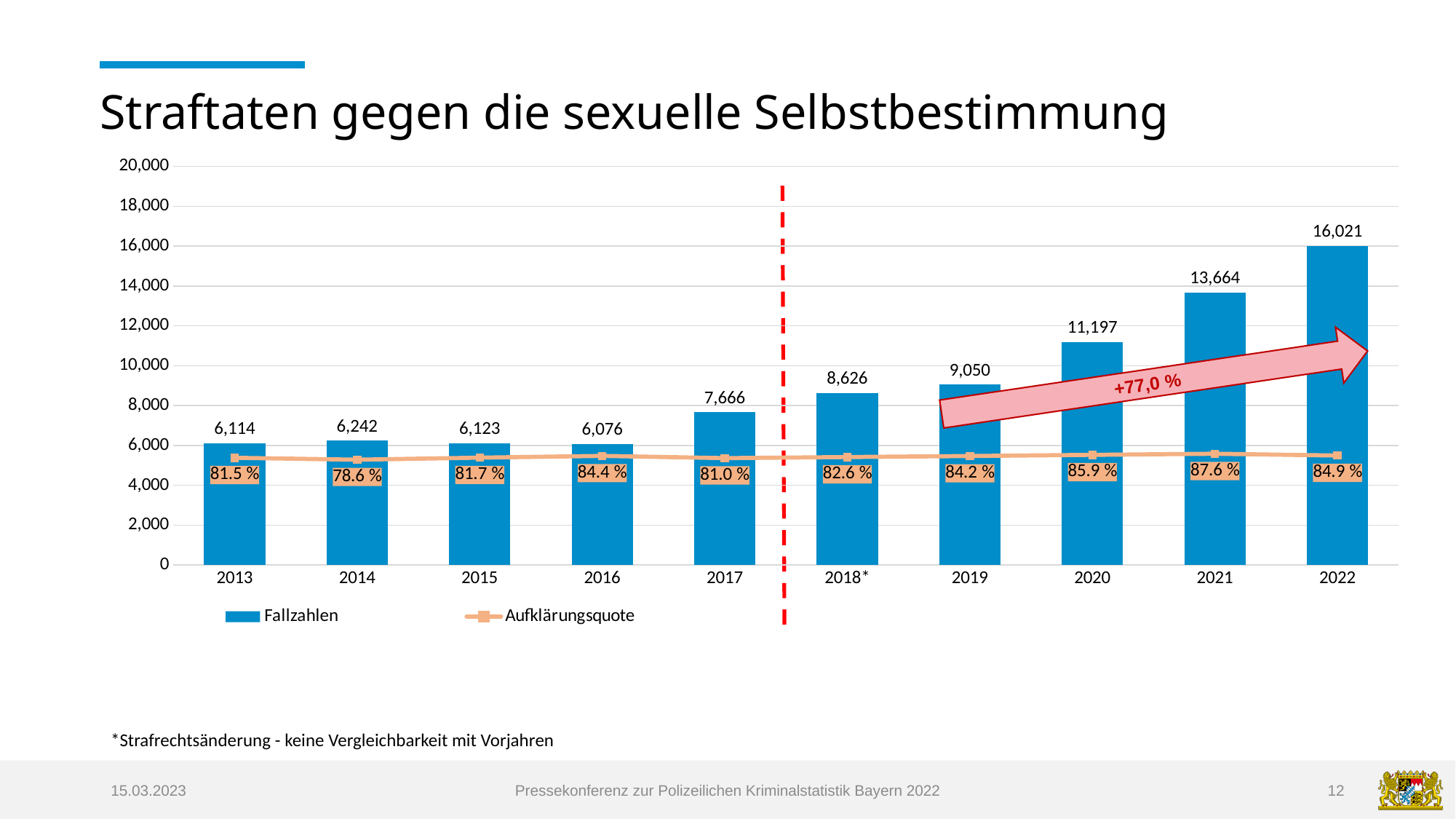
Which year has the lowest Fallzahlen value? 2016 What is the Aufklärungsquote for 2021? 87.6 % Is the Fallzahlen value for 2020 greater or less than 10,000? greater What percentage change is shown in the red arrow on the chart? +77,0 % How many series does the legend list? 2 What is the difference in Fallzahlen between 2022 and 2021? 2,357 How many years are shown on the x axis? 10 What is the Fallzahlen value for 2018*? 8,626 Which year has the highest Fallzahlen value? 2022 Which is larger, the Fallzahlen value for 2017 or for 2019? 2019 What is the Fallzahlen value for 2022? 16,021 Which year has the lowest Aufklärungsquote? 2014